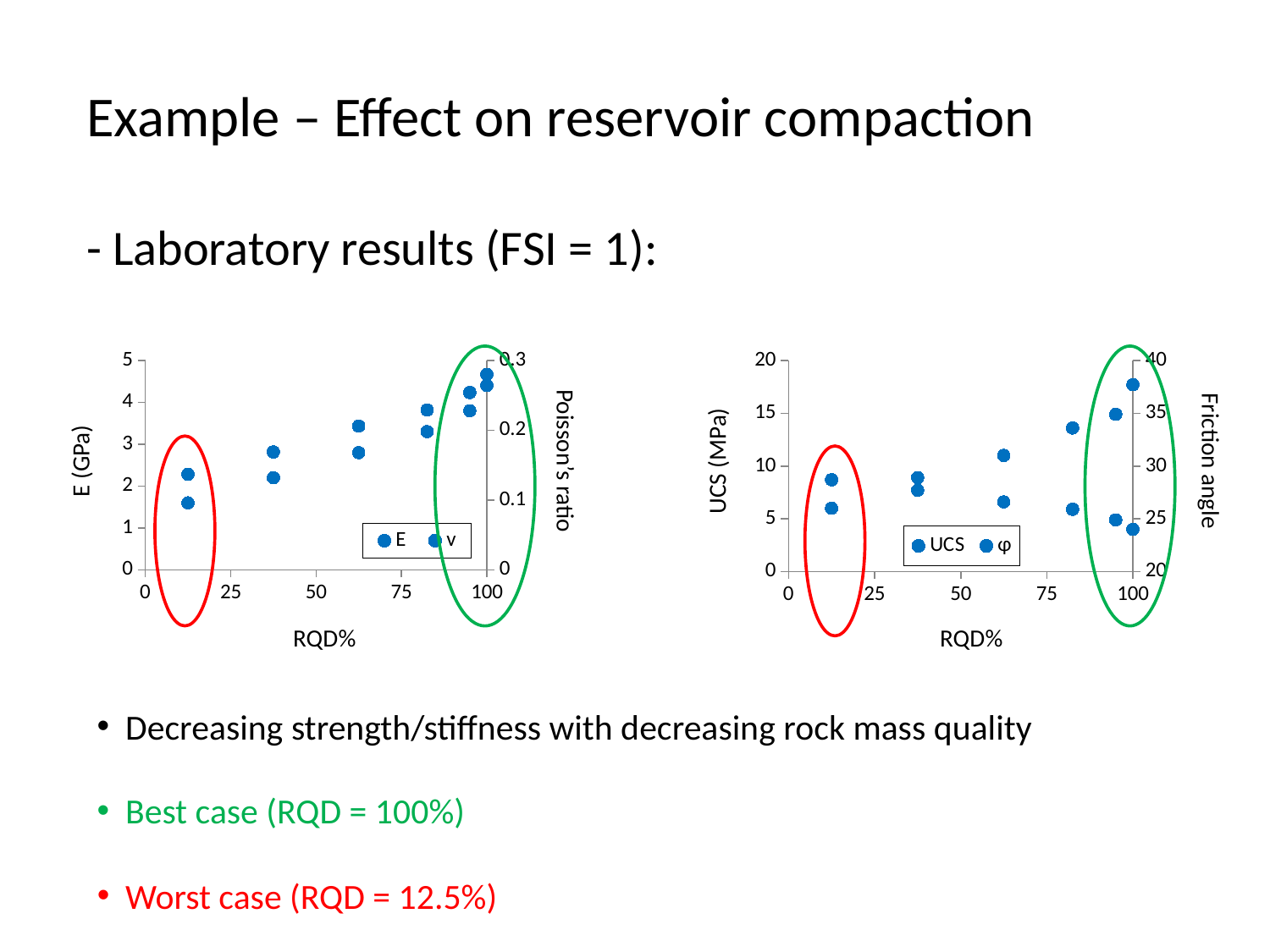
In the left chart, do the plotted values generally rise or fall as RQD% increases? rise What kind of chart is the left chart (E (GPa) vs RQD%)? scatter chart What kind of chart is the right chart (UCS (MPa) vs RQD%)? scatter chart What is the x-axis label of the right chart? RQD% How many series does the legend of the right chart list? 2 What are the two series named in the legend of the right chart? UCS and φ How many series does the legend of the left chart list? 2